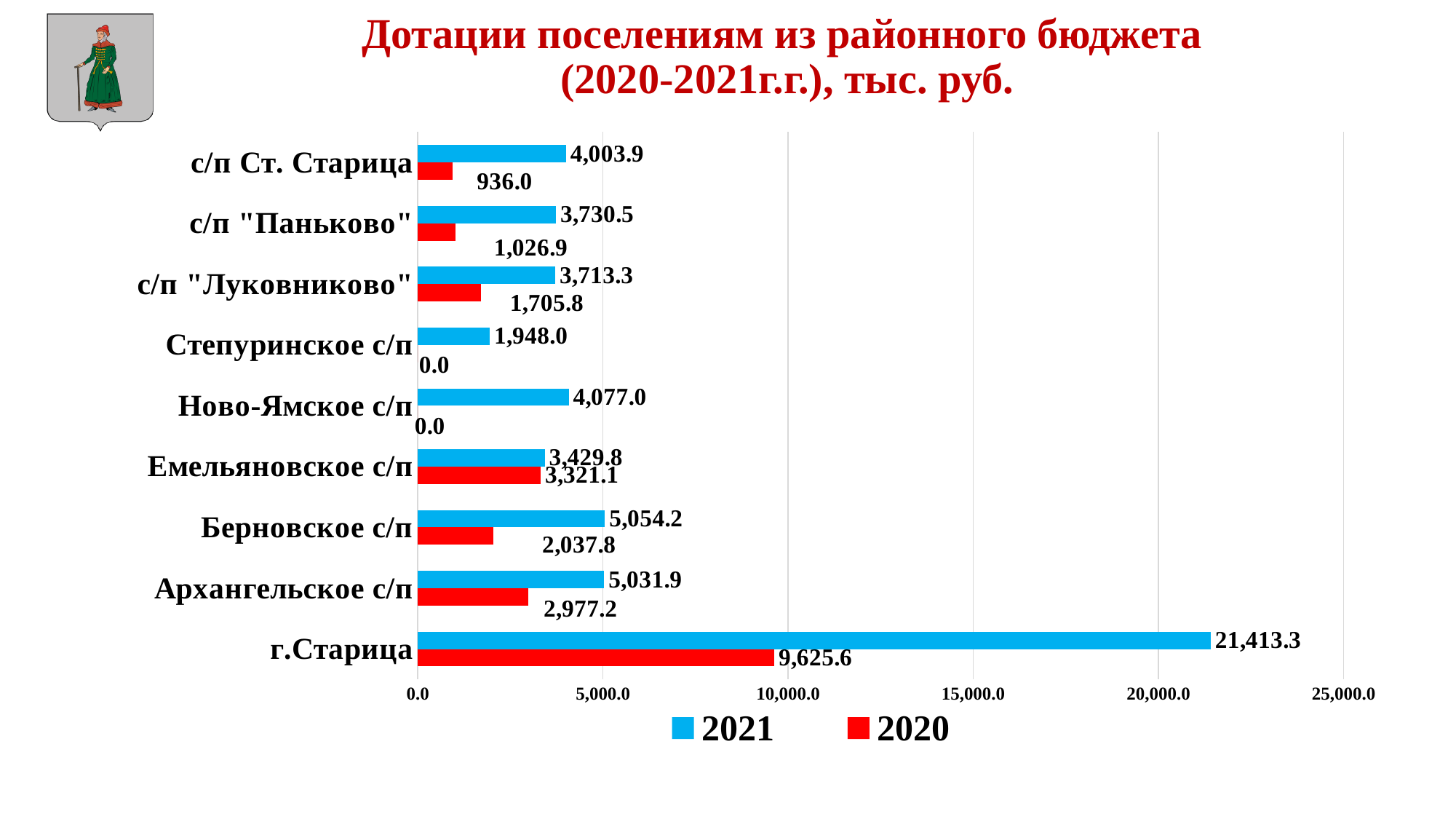
Which settlement has the highest 2020 value? г.Старица What type of chart is shown on the slide? bar chart What is the 2021 value for Ново-Ямское с/п? 4,077.0 What is the 2021 value for г.Старица? 21,413.3 Which settlement has the lowest 2021 value? Степуринское с/п Which colour represents the 2020 series in the legend? red What is the difference between the 2021 and 2020 values for Берновское с/п? 3,016.4 How many series does the legend list? 2 What is the difference between the 2021 and 2020 values for г.Старица? 11,787.7 Which is larger: the 2020 value for с/п "Луковниково" or the 2020 value for с/п "Паньково"? с/п "Луковниково" What is the 2020 value for с/п "Луковниково"? 1,705.8 How many settlements (categories) are shown on the chart? 9